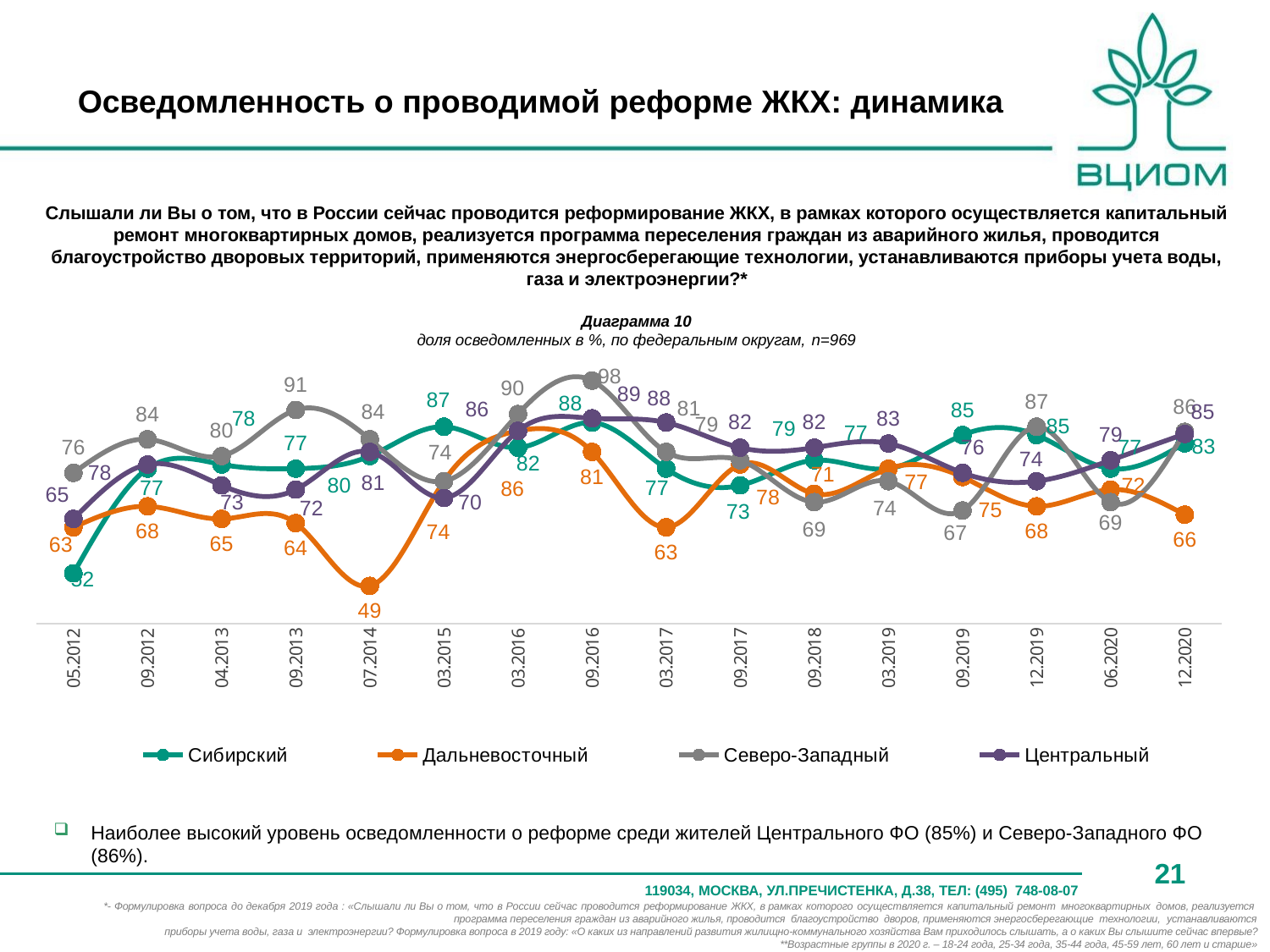
In 12.2020, which is larger: Центральный or Дальневосточный? Центральный What kind of chart is Диаграмма 10? line chart How many series does the legend of Диаграмма 10 list? 4 What is the value for Сибирский in 05.2012? 52 What is the value for Северо-Западный in 09.2013? 91 What is the difference between Северо-Западный (86) and Дальневосточный (66) in 12.2020? 20 In which period does Северо-Западный reach its highest value? 09.2016 What is the value for Дальневосточный in 07.2014? 49 What is the value for Северо-Западный in 09.2016? 98 What colour is the Дальневосточный line in the legend? orange In which period does Дальневосточный reach its lowest value? 07.2014 How many time points are shown on the x axis of Диаграмма 10? 16